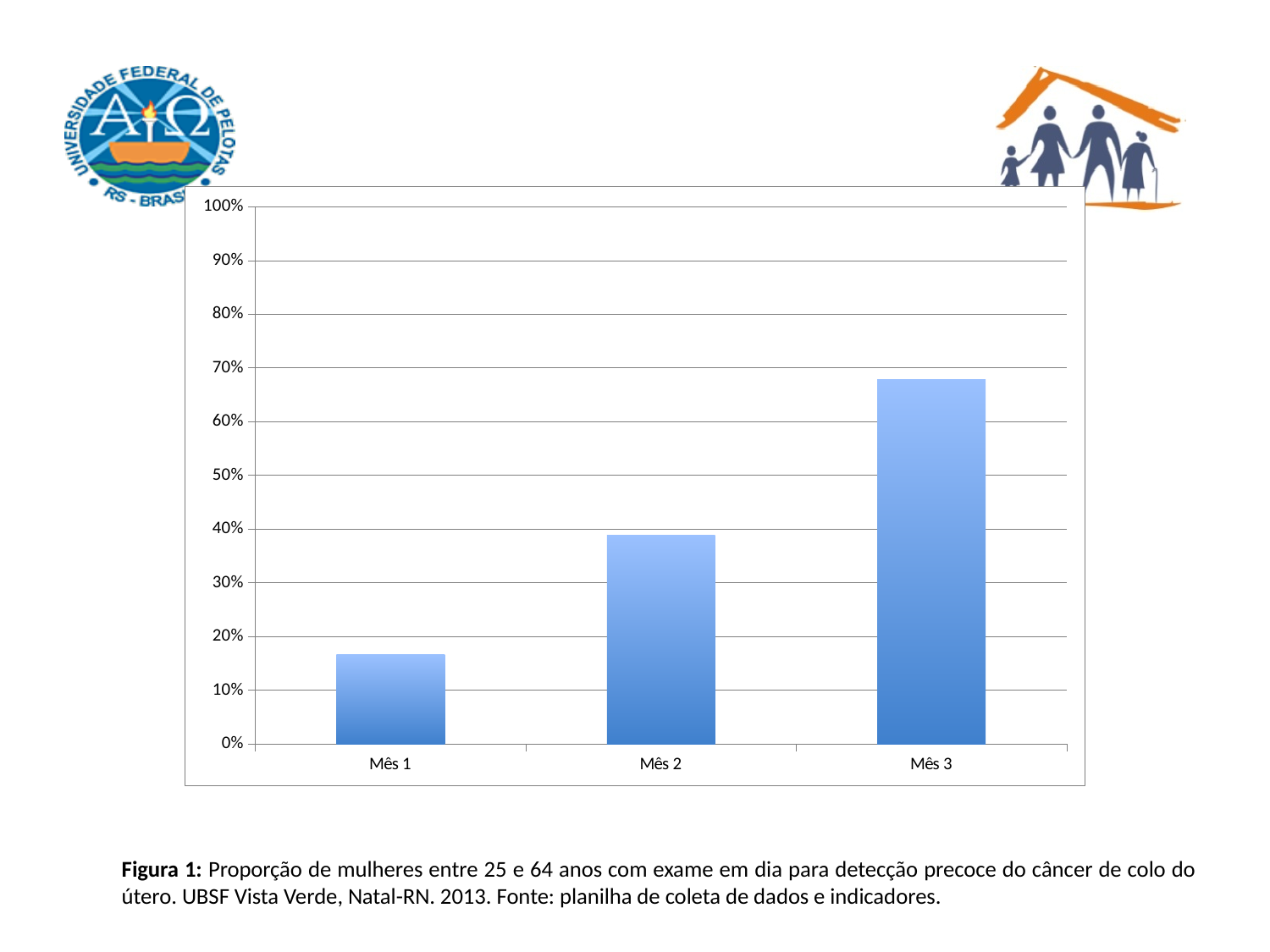
Which is larger, the value for Mês 2 or the value for Mês 3? Mês 3 What kind of chart is shown on the slide? bar chart Which month has the lowest value on the chart? Mês 1 Is the value for Mês 3 greater or less than 60%? greater What is the maximum value shown on the vertical axis of the chart? 100% According to the caption, in which city was the data for the chart collected? Natal-RN Do the values rise or fall from Mês 1 to Mês 3? rise Which month has the highest value on the chart? Mês 3 Is the value for Mês 2 greater or less than 30%? greater Is the value for Mês 3 greater or less than 70%? less How many categories (months) are plotted on the chart? 3